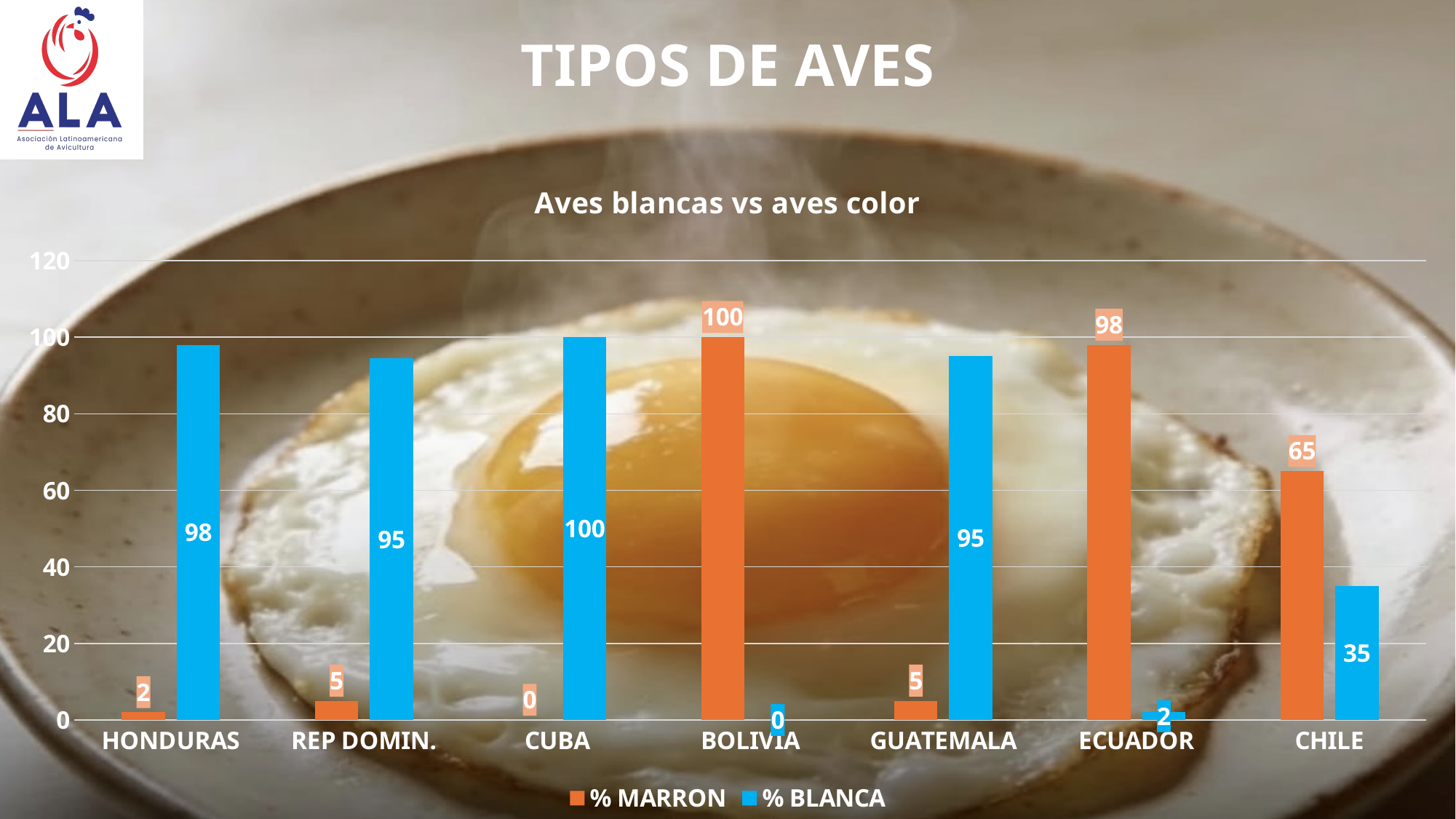
What is the title of the chart? Aves blancas vs aves color How many countries are shown on the x axis? 7 Which country has the lowest % BLANCA value? BOLIVIA What is the difference between the % BLANCA and % MARRON values for CHILE? 30 What is the % MARRON value for BOLIVIA? 100 Which country has the highest % MARRON value? BOLIVIA Which is larger for GUATEMALA, % MARRON or % BLANCA? % BLANCA How many series does the legend list? 2 What is the % BLANCA value for CHILE? 35 What is the % BLANCA value for REP DOMIN.? 95 What kind of chart is shown on the slide? Bar chart What is the % MARRON value for ECUADOR? 98